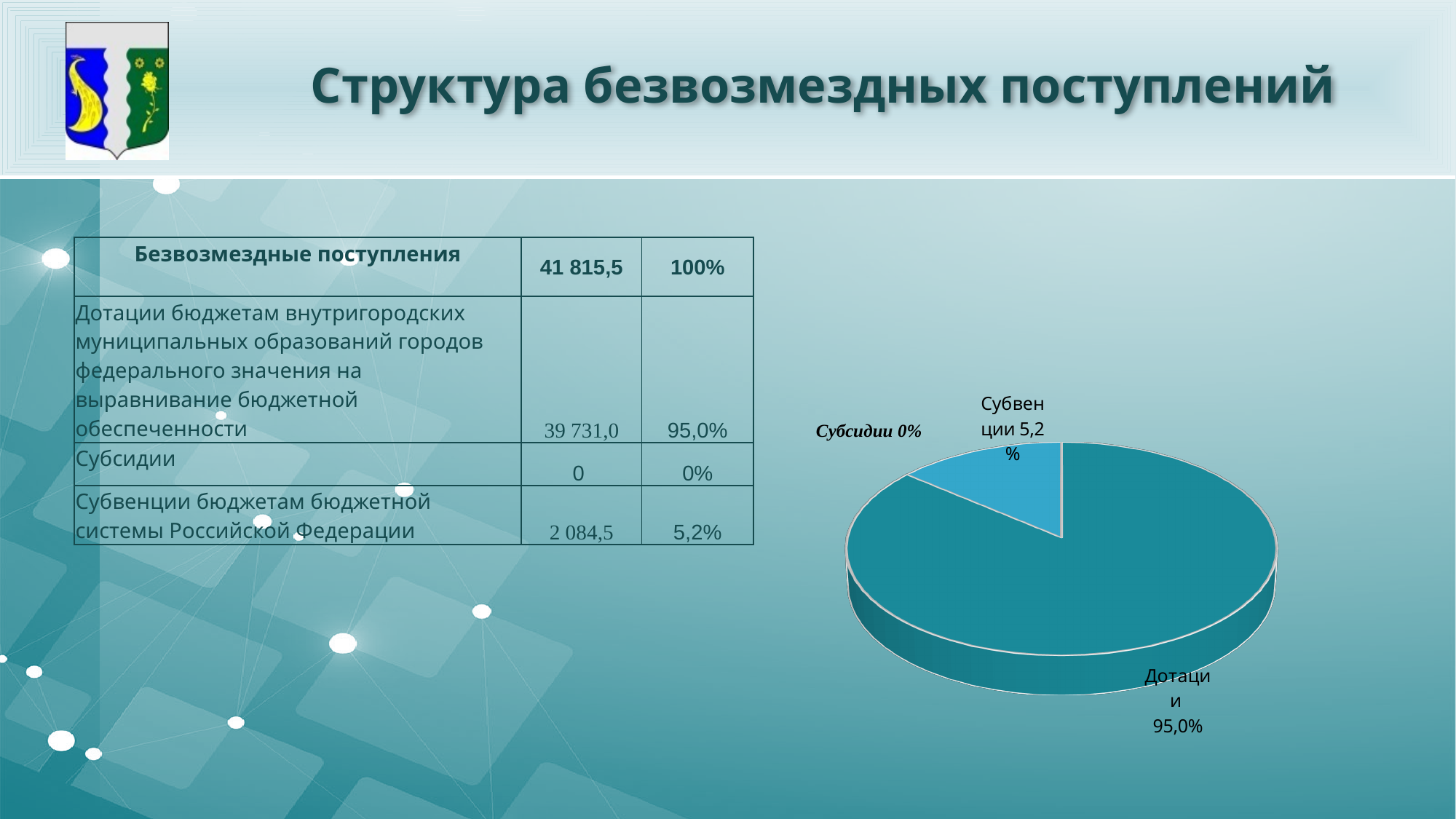
What share of the pie does the Субсидии slice represent? 0% What is the title of the slide containing the pie chart? Структура безвозмездных поступлений Is the share for Дотации greater or less than 50%? greater What share of the pie does the Субвенции slice represent? 5,2% What share of the pie does the Дотации slice represent? 95,0% What is the difference in percentage points between the Дотации and Субвенции slices? 89,8 What kind of chart is shown on the slide? pie chart How many categories are labelled on the pie chart? 3 Which is larger in the pie chart, Дотации or Субвенции? Дотации Which slice of the pie chart is drawn in a lighter blue colour? Субвенции Which category has the smallest slice in the pie chart? Субсидии Which category has the largest slice in the pie chart? Дотации